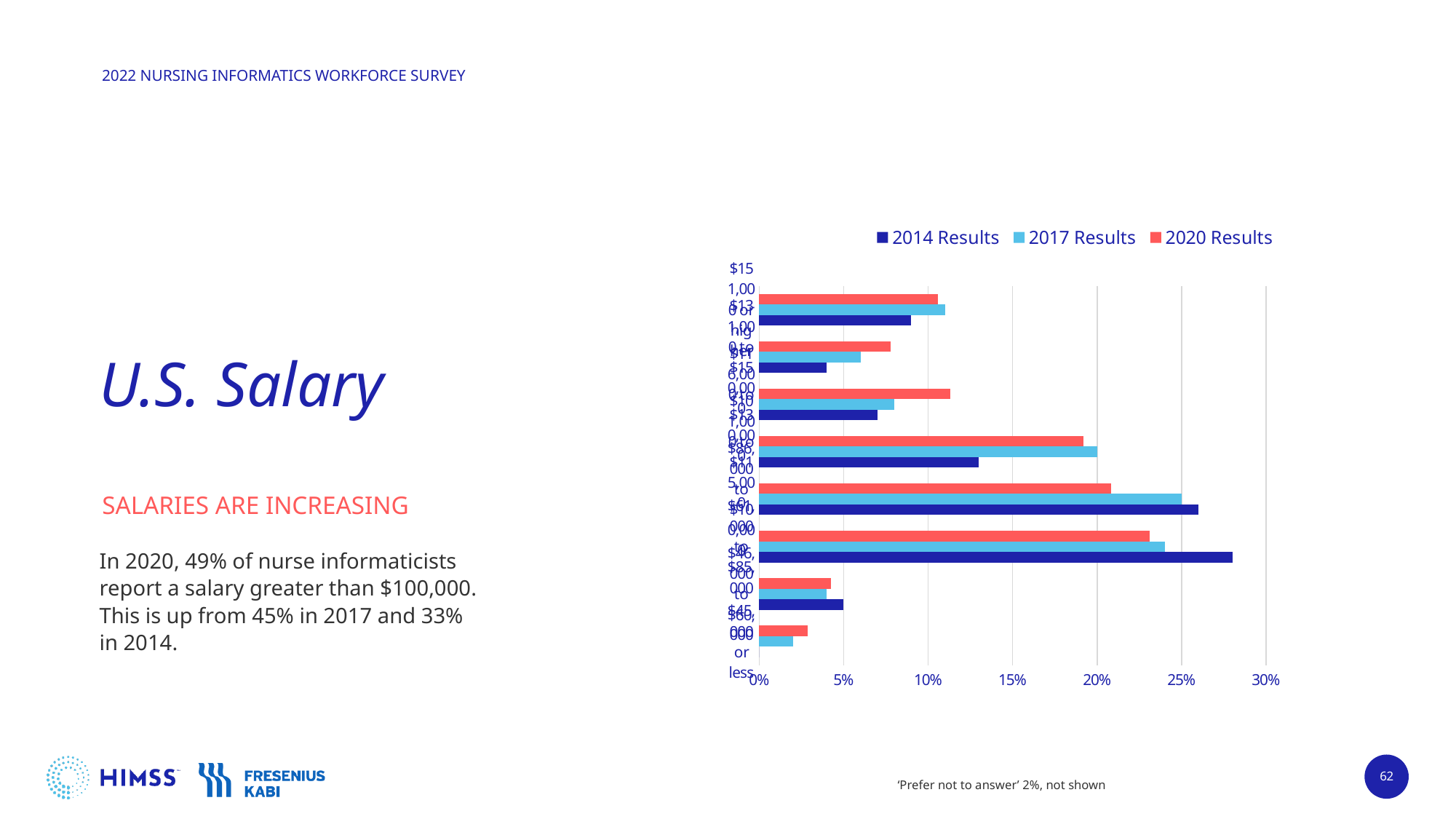
Is the longest bar on the chart greater or less than 25%? greater In the topmost group of bars on the chart, is the 2014 Results value greater or less than 10%? less In the bottom group of bars on the chart, is the 2020 Results value greater or less than 5%? less What is the highest value shown on the chart's horizontal axis? 30% What kind of chart is shown on the slide? bar chart What are the three series named in the chart legend? 2014 Results, 2017 Results, 2020 Results How many salary categories (groups of bars) are plotted on the chart? 8 Which series has the single longest bar on the chart? 2014 Results How many series does the chart legend list? 3 In the bottom group of bars on the chart, which is larger, the 2017 Results bar or the 2020 Results bar? 2020 Results